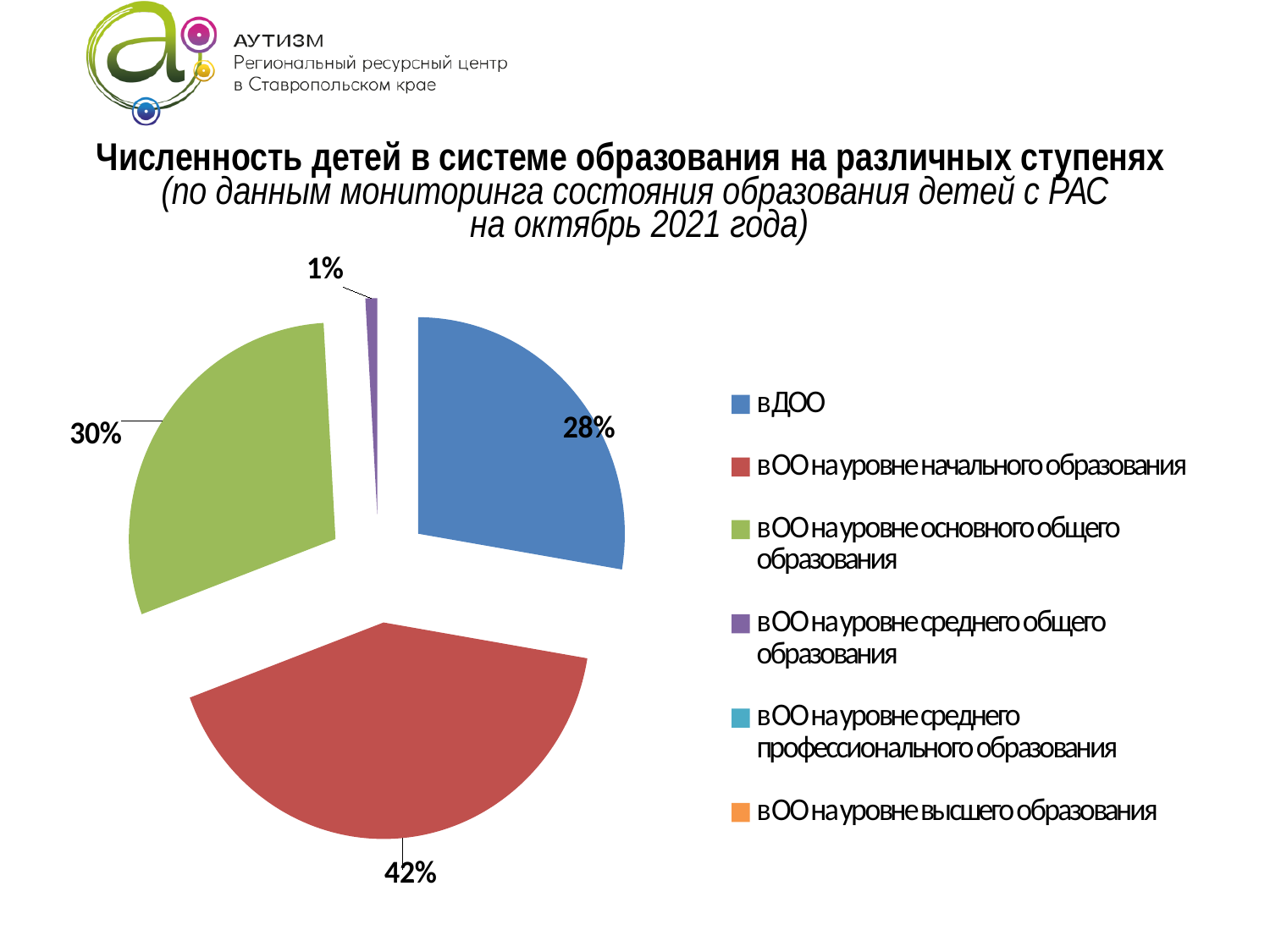
What kind of chart is shown on the slide? pie chart What share of children is in ОО на уровне среднего общего образования? 1% Which labelled category has the smallest slice of the pie? в ОО на уровне среднего общего образования Which is larger: the share in ДОО or the share in ОО на уровне основного общего образования? в ОО на уровне основного общего образования What colour is the slice for в ОО на уровне начального образования? red How many entries does the legend list? 6 What is the difference in percentage points between the share in ОО на уровне начального образования and the share in ДОО? 14 What share of children is in ОО на уровне основного общего образования? 30% What share of children is in ОО на уровне начального образования? 42% What colour is the slice for в ДОО? blue What share of children is in ДОО according to the pie chart? 28% Which category has the largest slice of the pie? в ОО на уровне начального образования